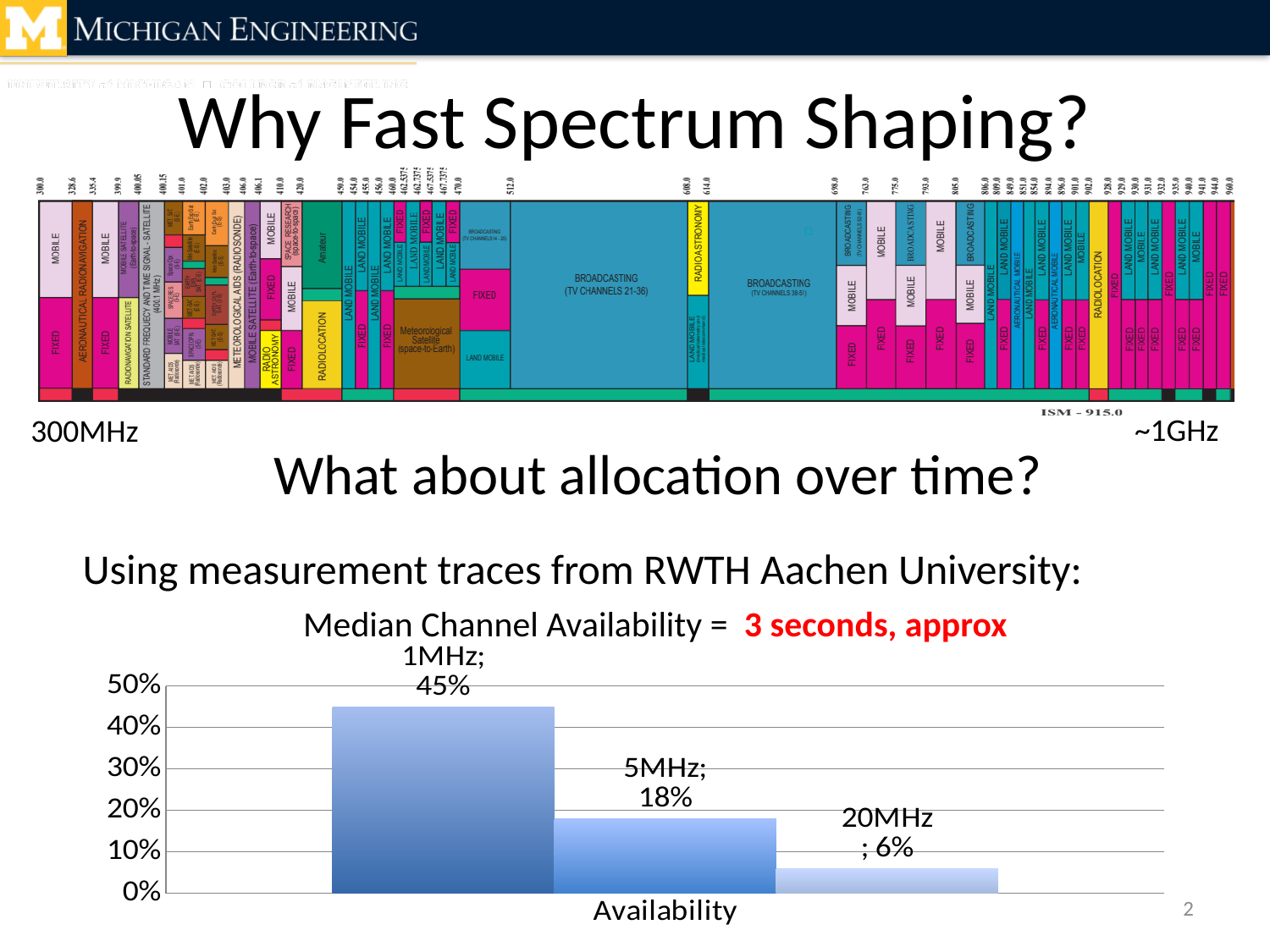
What is the availability value for 5MHz? 18% How many bars are shown in the bar chart? 3 What is the difference between the availability for 5MHz and 20MHz? 12% Which bandwidth has the highest availability in the bar chart? 1MHz Is the availability value for 1MHz greater or less than 40%? greater Which bandwidth has the lowest availability in the bar chart? 20MHz What is the availability value for 1MHz? 45% What kind of chart is shown at the bottom of the slide? bar chart What is the availability value for 20MHz? 6% What is the label shown on the x axis of the bar chart? Availability What is the difference between the availability for 1MHz and 5MHz? 27% Which has a larger availability value, 5MHz or 20MHz? 5MHz